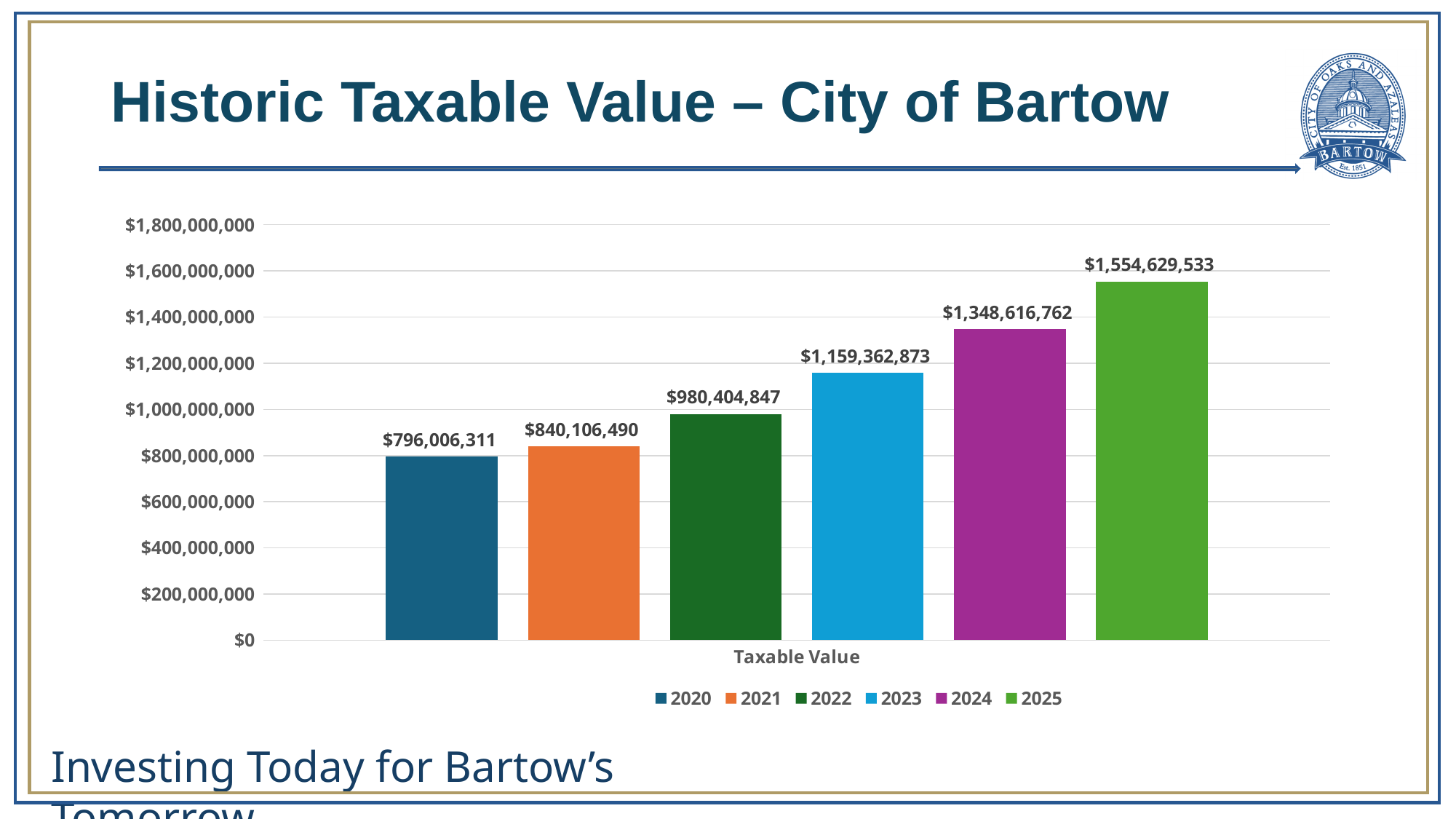
What is the taxable value shown for 2023? $1,159,362,873 What is the difference between the taxable values for 2025 and 2024? $206,012,771 Which year has the lowest taxable value? 2020 What kind of chart is shown on the slide? Bar chart Do the taxable values rise or fall from 2020 to 2025? Rise What is the taxable value shown for 2025? $1,554,629,533 By how much did the taxable value increase from 2020 to 2021? $44,100,179 Is the taxable value for 2024 greater or less than $1,200,000,000? greater How many series does the legend list? 6 Which year has the highest taxable value? 2025 What is the taxable value shown for 2020? $796,006,311 Which is larger, the taxable value for 2022 or for 2023? 2023